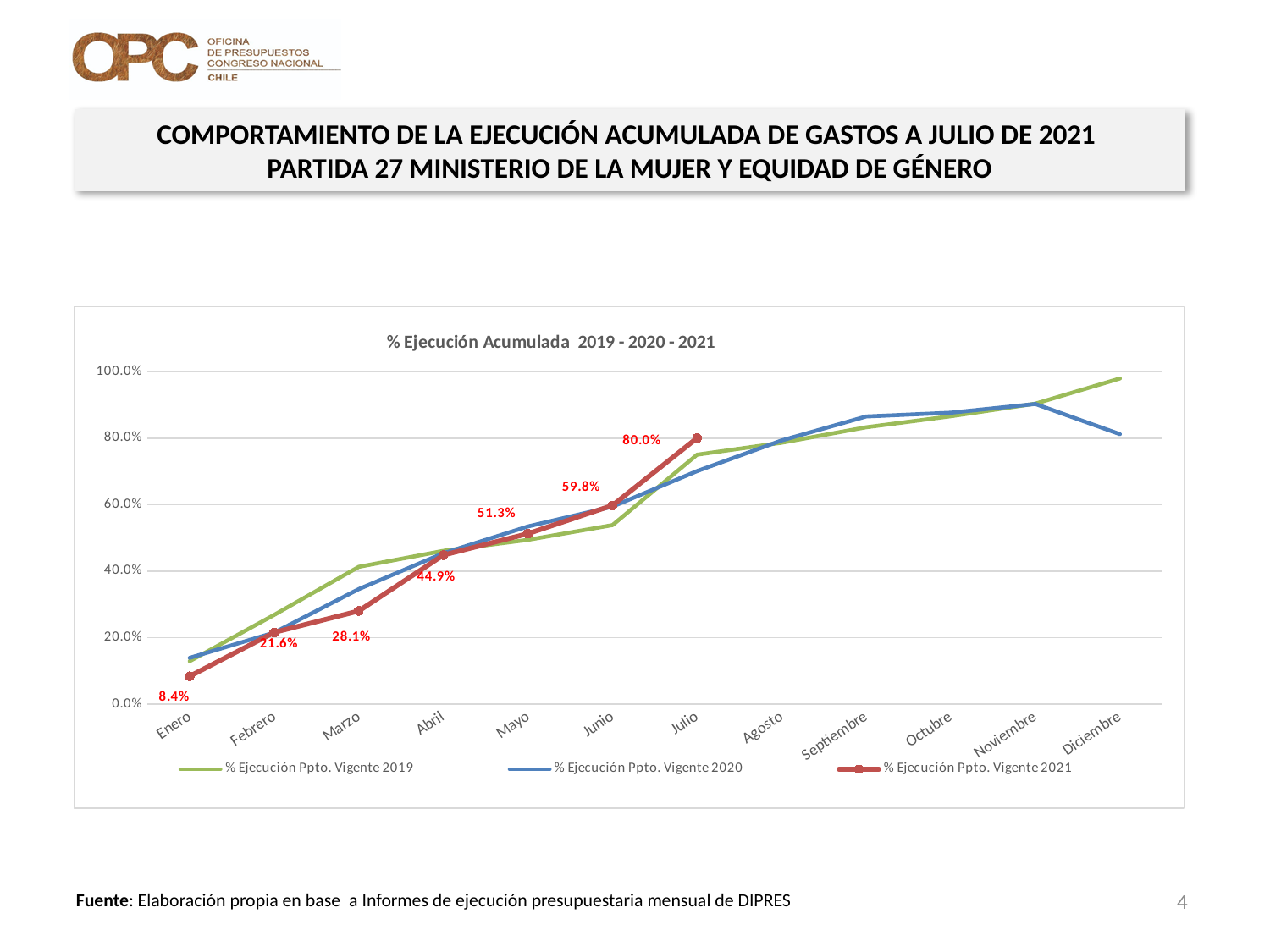
Is the value of % Ejecución Ppto. Vigente 2019 for Diciembre greater or less than 80.0%? greater Which series has the higher value in Diciembre, % Ejecución Ppto. Vigente 2019 or % Ejecución Ppto. Vigente 2020? % Ejecución Ppto. Vigente 2019 How many series does the chart legend list? 3 What is the value of % Ejecución Ppto. Vigente 2021 for Julio? 80.0% What type of chart is shown on the slide? Line chart What is the value of % Ejecución Ppto. Vigente 2021 for Abril? 44.9% What is the value of % Ejecución Ppto. Vigente 2021 for Enero? 8.4% By how many percentage points does the 2021 series increase from Junio to Julio? 20.2 What is the value of % Ejecución Ppto. Vigente 2021 for Marzo? 28.1% Which month has the highest value for the % Ejecución Ppto. Vigente 2021 series? Julio How many months are shown on the x axis of the chart? 12 Is the value of % Ejecución Ppto. Vigente 2020 for Septiembre greater or less than 80.0%? greater